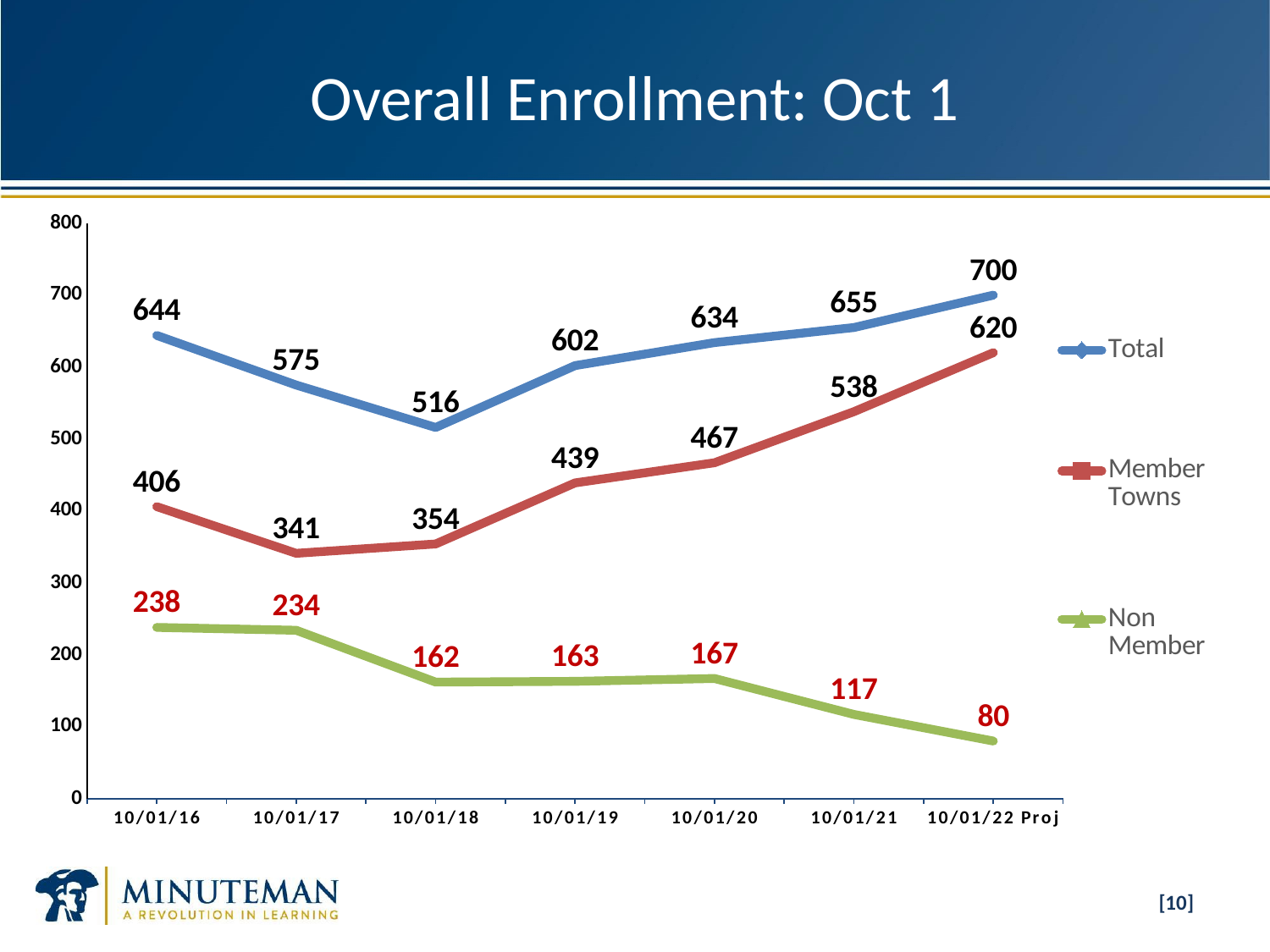
Which date has the highest Total enrollment? 10/01/22 Proj What is the Member Towns value for 10/01/21? 538 What is the Total enrollment value for 10/01/18? 516 What is the difference between the Total values for 10/01/22 Proj and 10/01/16? 56 Which is larger, the Non Member value for 10/01/16 or for 10/01/20? 10/01/16 What kind of chart is shown on the slide? line chart Which date has the lowest Member Towns value? 10/01/17 What is the Non Member value for 10/01/22 Proj? 80 How many dates are shown on the x axis? 7 Is the Member Towns value for 10/01/19 greater or less than 400? greater How many series does the legend list? 3 Does the Non Member series rise or fall from 10/01/20 to 10/01/22 Proj? fall